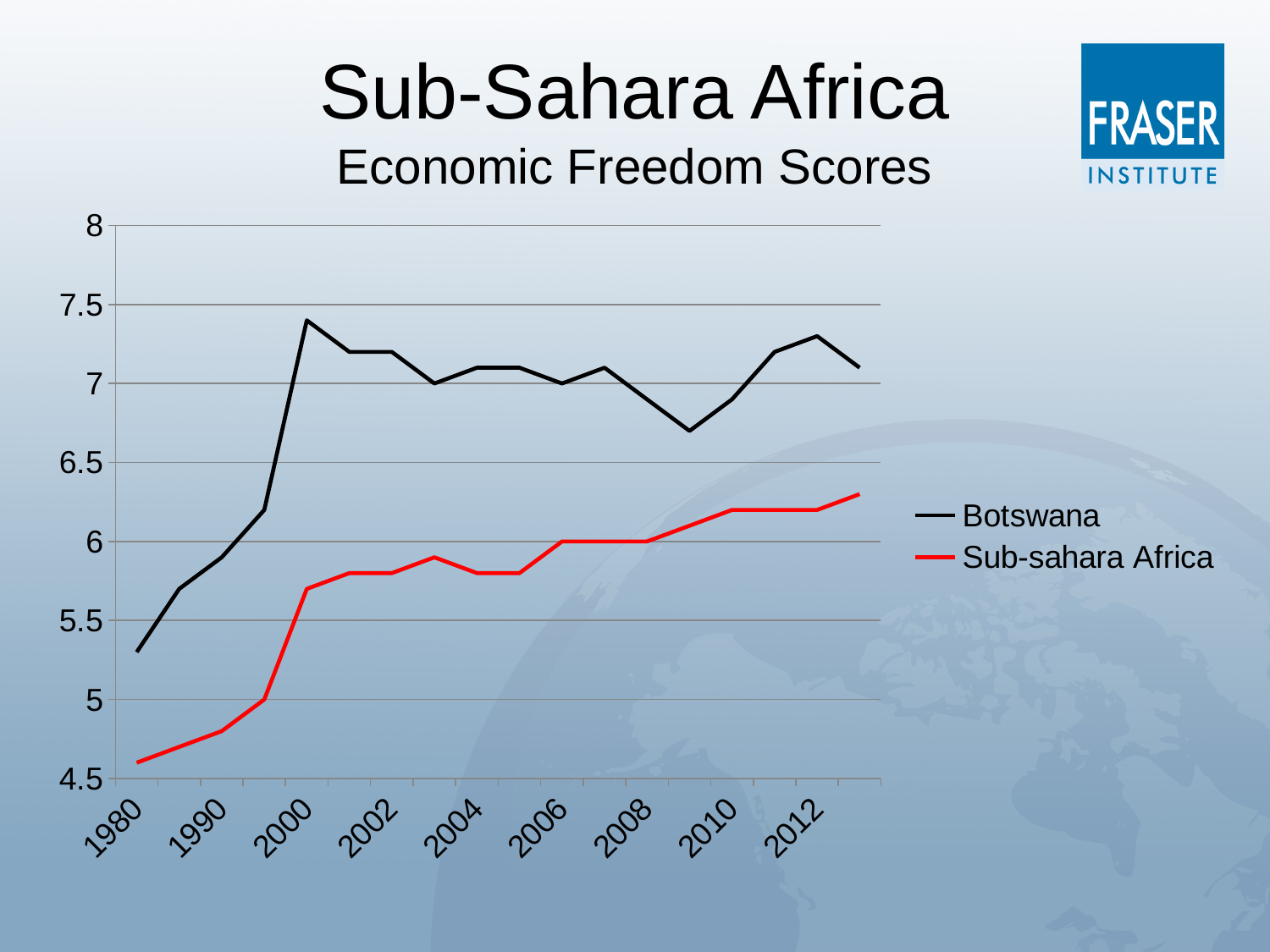
What are the two series named in the legend? Botswana and Sub-sahara Africa Is the Botswana value for 2000 greater or less than 7? greater What colour is the Botswana line? black In 2000, which series has the higher score, Botswana or Sub-sahara Africa? Botswana Is the Sub-sahara Africa value for 2010 greater or less than 6? greater Is the Sub-sahara Africa value for 1980 greater or less than 5? less Which series stays higher than the other across the whole period shown? Botswana How many series does the legend list? 2 What kind of chart is shown on the slide? line chart Does the Sub-sahara Africa line generally rise or fall from 1980 to 2012? rise